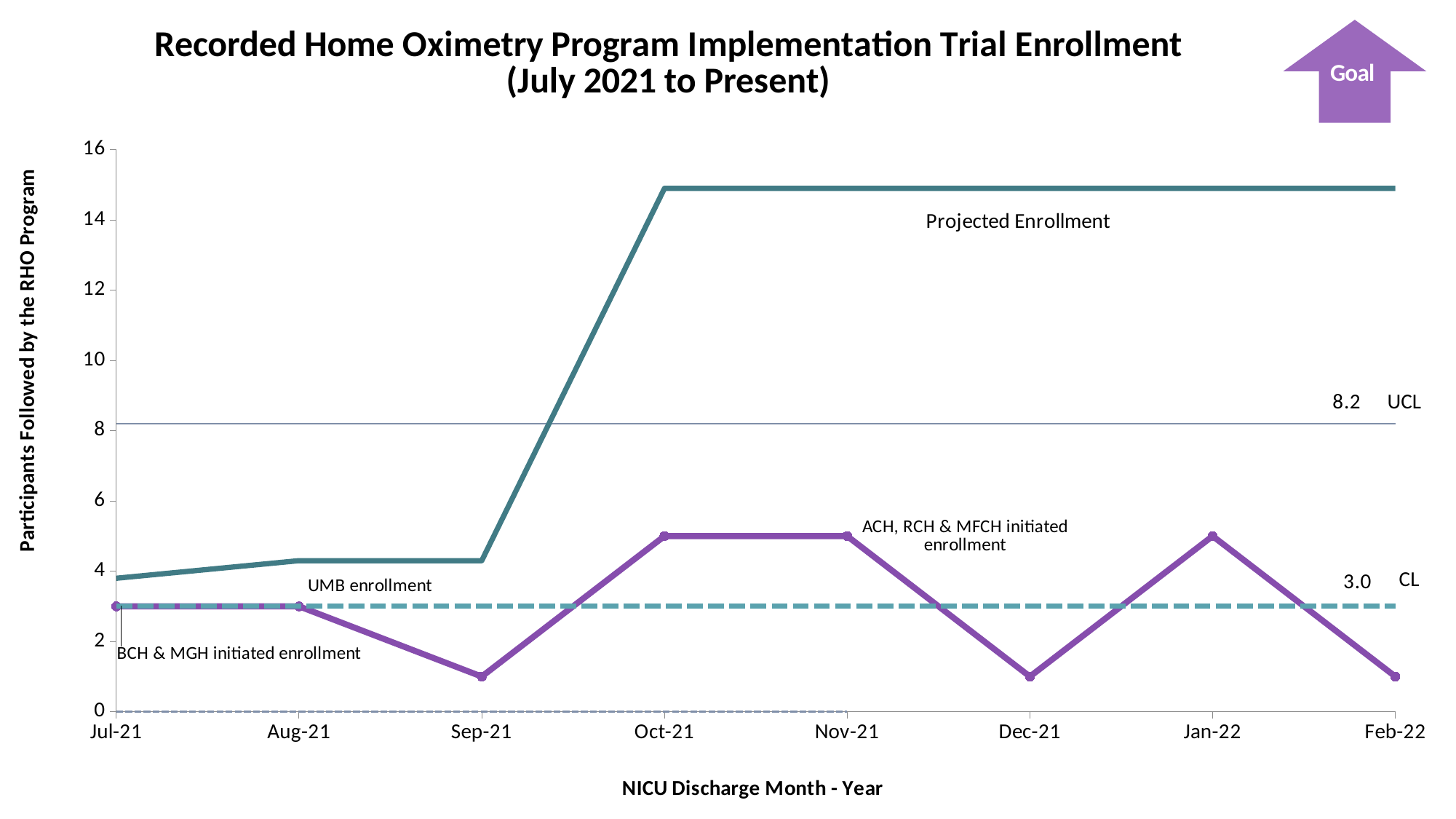
Which month has the higher enrollment on the purple line, Sep-21 or Oct-21? Oct-21 What kind of chart is shown on the slide? line chart Does the Projected Enrollment line rise or fall between Sep-21 and Oct-21? rise Is the Projected Enrollment value at Jul-21 greater or less than 4? less What is the label on the x axis of the chart? NICU Discharge Month - Year How many months are shown along the x axis of the chart? 8 Is the enrollment value for Oct-21 on the purple line greater or less than 4? greater Is the Projected Enrollment value at Oct-21 greater or less than 14? greater What annotation is attached to the Aug-21 point on the purple line? UMB enrollment What is the value of the UCL line shown on the chart? 8.2 What is the value of the CL line shown on the chart? 3.0